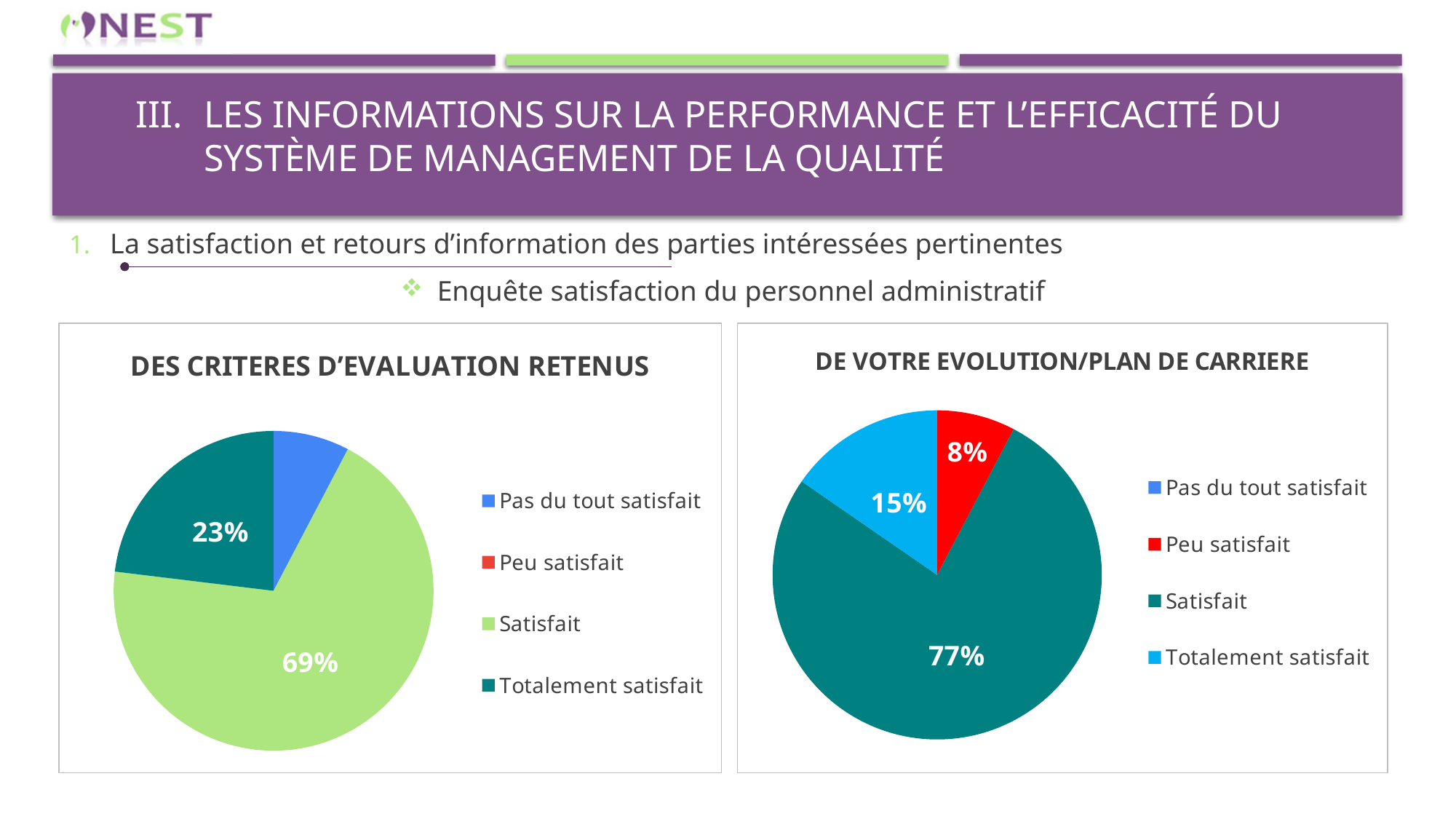
In the chart titled 'DE VOTRE EVOLUTION/PLAN DE CARRIERE', what share of respondents are 'Satisfait'? 77% In the chart titled 'DE VOTRE EVOLUTION/PLAN DE CARRIERE', which labelled category has the smallest slice? Peu satisfait In the chart titled 'DES CRITERES D'EVALUATION RETENUS', what share of respondents are 'Totalement satisfait'? 23% What type of chart is used on the left side of the slide, titled 'DES CRITERES D'EVALUATION RETENUS'? Pie chart In the chart titled 'DES CRITERES D'EVALUATION RETENUS', what share of respondents are 'Satisfait'? 69% In the chart titled 'DE VOTRE EVOLUTION/PLAN DE CARRIERE', which is larger: 'Totalement satisfait' or 'Peu satisfait'? Totalement satisfait In the chart titled 'DES CRITERES D'EVALUATION RETENUS', what is the difference in percentage points between 'Satisfait' and 'Totalement satisfait'? 46 In the chart titled 'DE VOTRE EVOLUTION/PLAN DE CARRIERE', what is the difference in percentage points between 'Satisfait' and 'Totalement satisfait'? 62 In the chart titled 'DES CRITERES D'EVALUATION RETENUS', which category has the largest slice? Satisfait How many entries does the legend of the chart titled 'DE VOTRE EVOLUTION/PLAN DE CARRIERE' list? 4 In the chart titled 'DE VOTRE EVOLUTION/PLAN DE CARRIERE', what share of respondents are 'Totalement satisfait'? 15% In the chart titled 'DE VOTRE EVOLUTION/PLAN DE CARRIERE', what share of respondents are 'Peu satisfait'? 8%